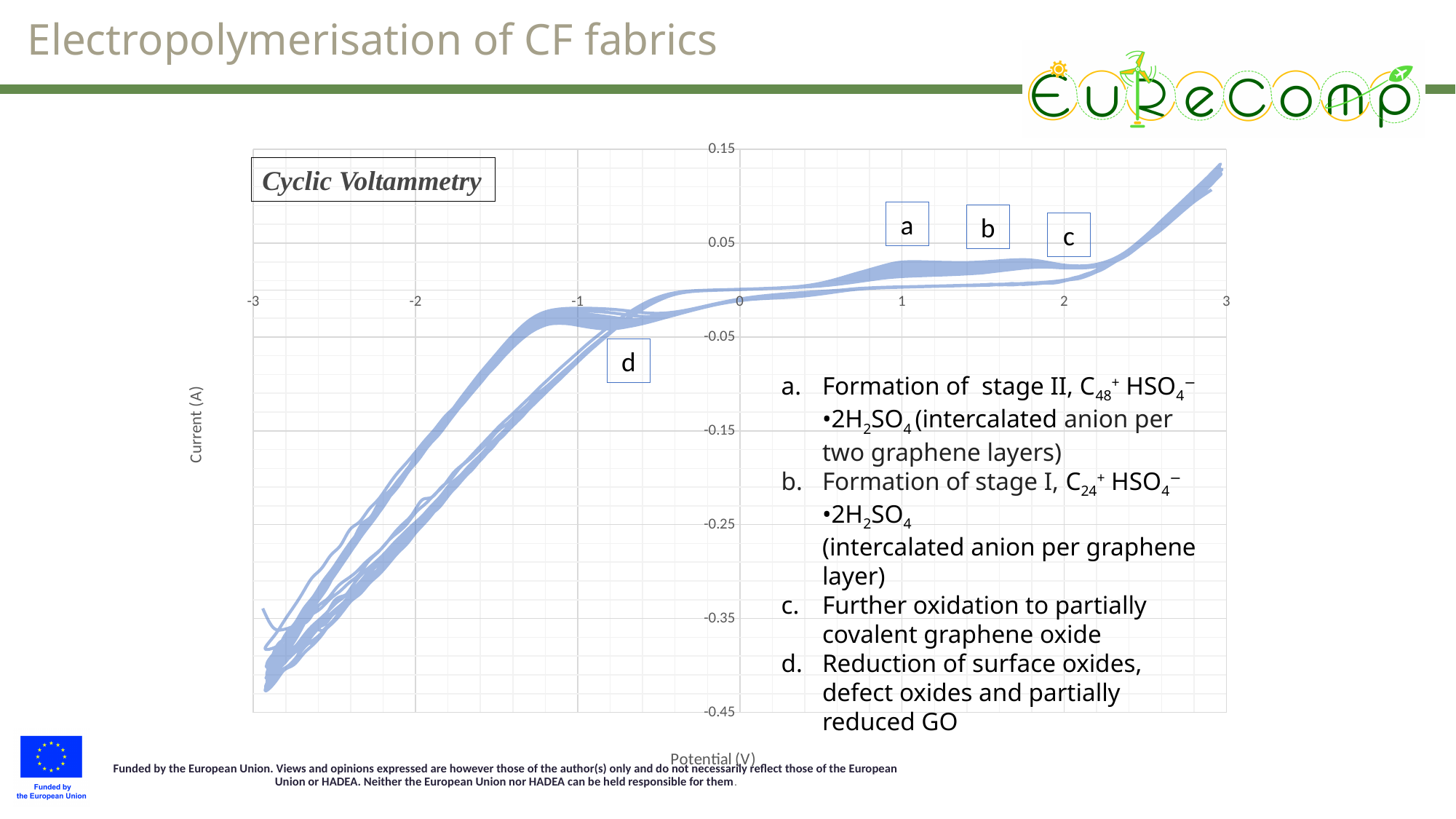
Is the current at a potential of 1 V greater or less than 0.05? less Is the current at a potential of -3 V greater or less than -0.25? less How many lettered annotation labels (a, b, c, d) are placed on the chart? 4 Overall, does the current rise or fall as the potential increases from -3 to 3? rise Is the current at a potential of -2 V greater or less than -0.05? less What kind of chart is shown on the slide? line chart What is the label of the x axis of the chart? Potential (V) What is the title shown in the box on the chart? Cyclic Voltammetry Which is larger, the current at a potential of 3 V or the current at a potential of -3 V? 3 V What is the highest value shown on the y axis of the chart? 0.15